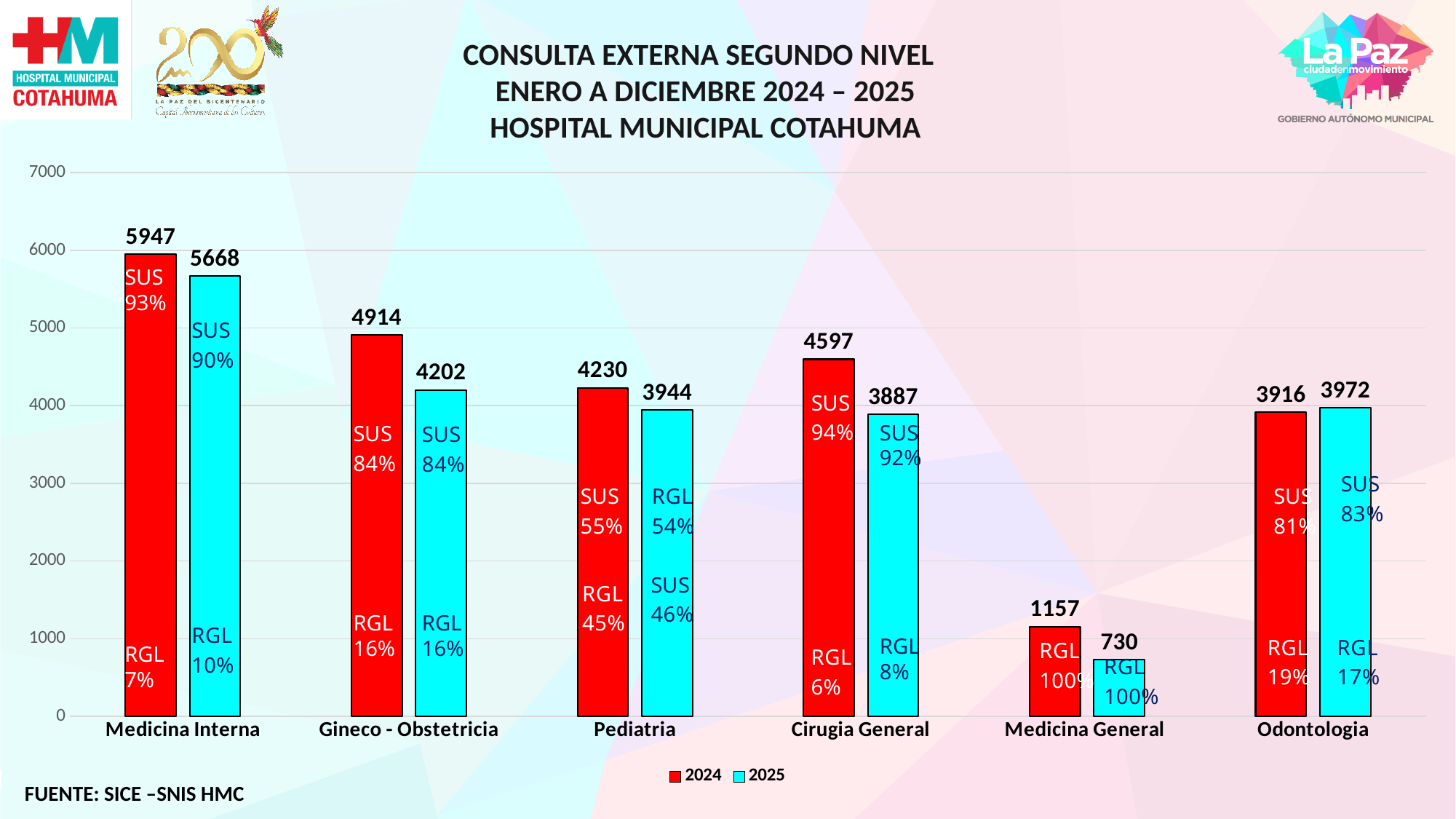
What is the 2024 value for Medicina Interna? 5947 For Odontologia, which is larger: the 2024 value or the 2025 value? 2025 What is the 2025 value for Gineco - Obstetricia? 4202 What is the 2025 value for Medicina General? 730 Which category has the highest 2024 value? Medicina Interna What kind of chart is shown on the slide? Bar chart What is the 2024 value for Cirugia General? 4597 What is the difference between the 2024 and 2025 values for Medicina Interna? 279 How many series does the legend list? 2 Which category has the lowest 2025 value? Medicina General What is the difference between the 2024 and 2025 values for Medicina General? 427 How many categories are shown on the x axis? 6